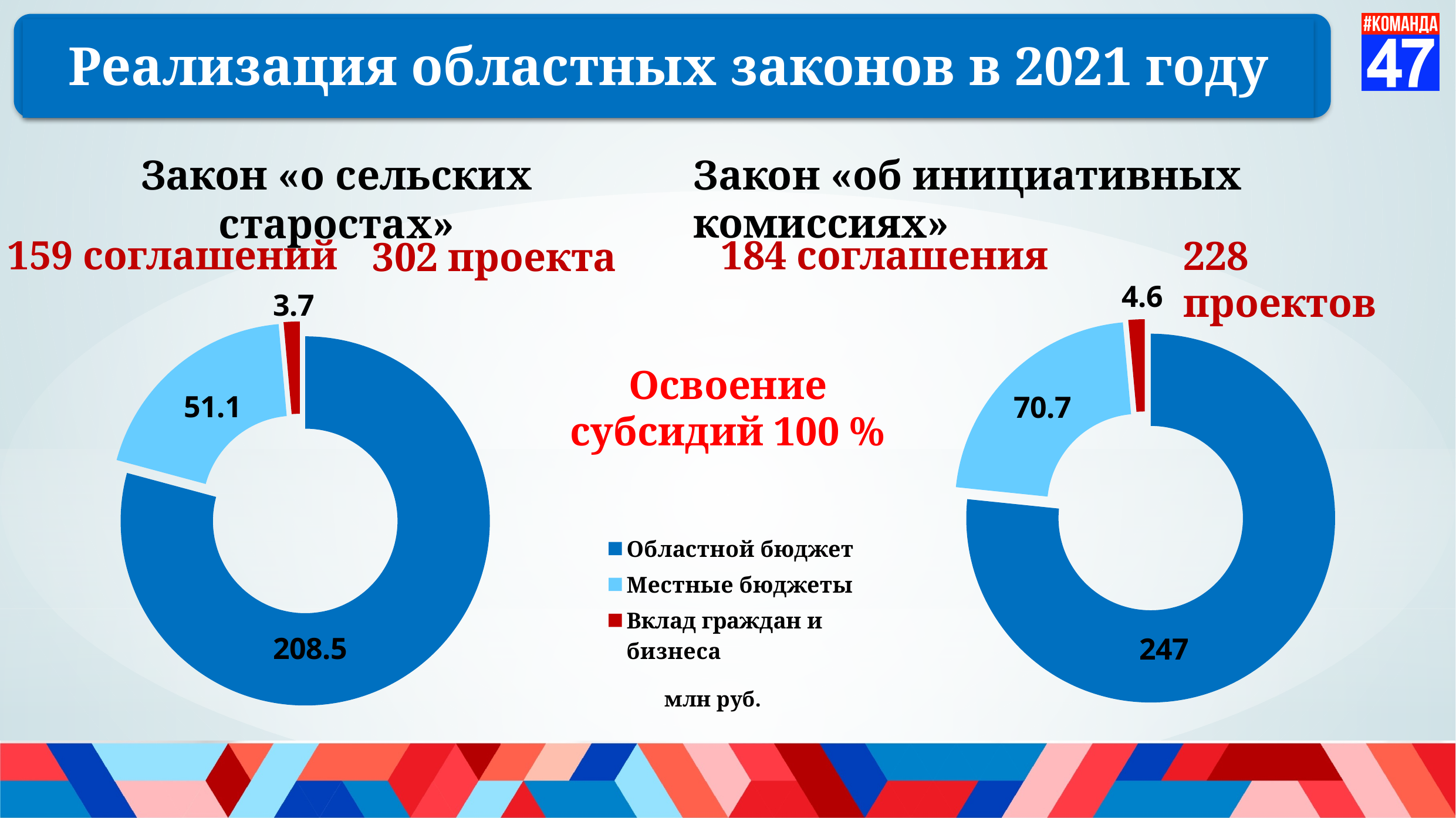
How many categories does the left chart (Закон «о сельских старостах») show? 3 In the right chart (Закон «об инициативных комиссиях»), what is the value for Местные бюджеты? 70.7 What unit is given for the values in the charts? млн руб. In the left chart (Закон «о сельских старостах»), what is the value for Областной бюджет? 208.5 In the left chart (Закон «о сельских старостах»), which category has the largest value? Областной бюджет In the right chart (Закон «об инициативных комиссиях»), what is the value for Вклад граждан и бизнеса? 4.6 What kind of chart is the right chart (Закон «об инициативных комиссиях»)? Doughnut chart In the right chart (Закон «об инициативных комиссиях»), which category has the smallest value? Вклад граждан и бизнеса Which is larger: Местные бюджеты in the left chart (Закон «о сельских старостах») or Местные бюджеты in the right chart (Закон «об инициативных комиссиях»)? The right chart (Закон «об инициативных комиссиях») How many entries does the legend list? 3 In the right chart (Закон «об инициативных комиссиях»), what is the difference between Областной бюджет and Местные бюджеты? 176.3 In the left chart (Закон «о сельских старостах»), what is the value for Местные бюджеты? 51.1